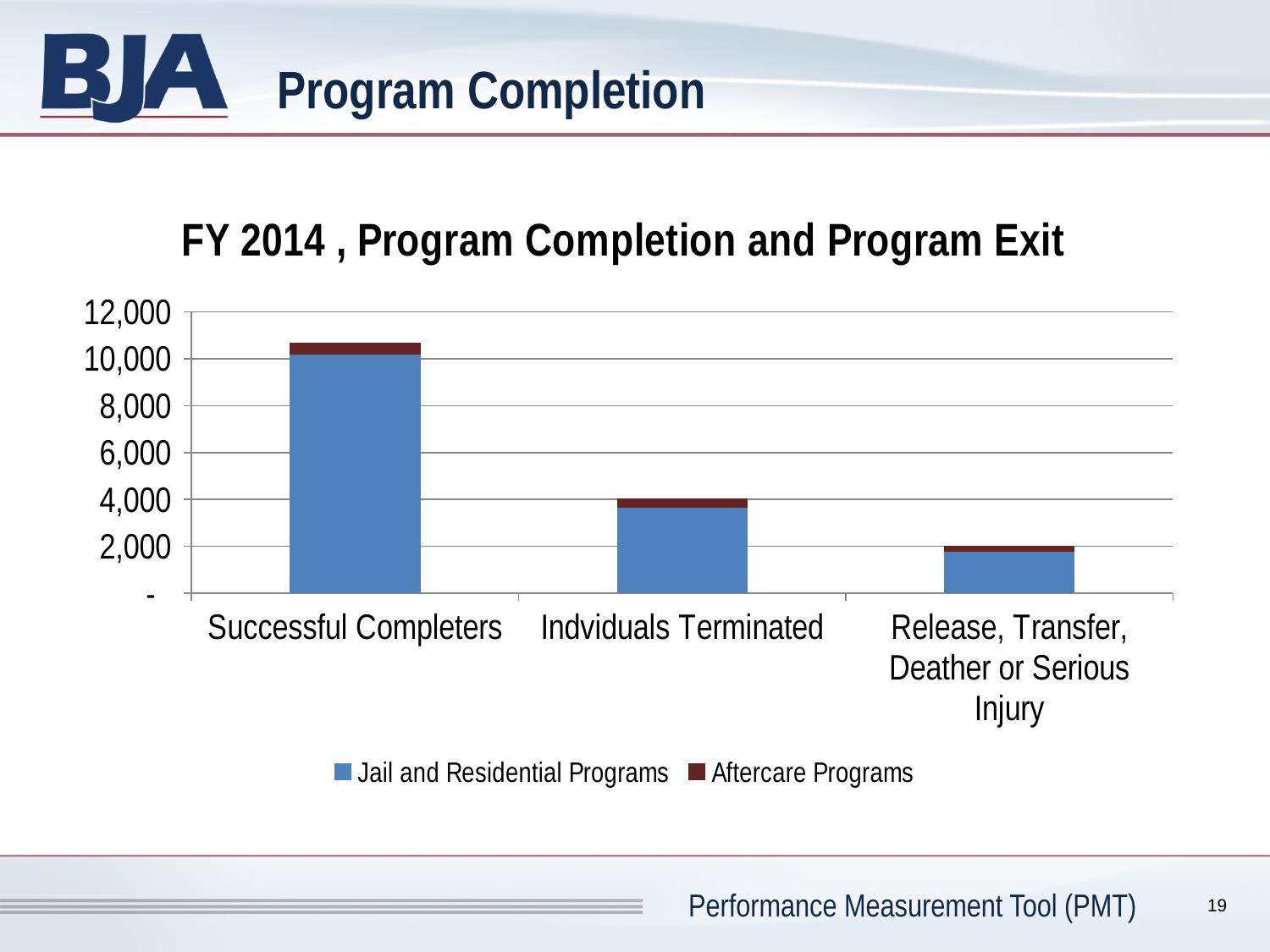
Which is larger, the total bar for Indviduals Terminated or the total bar for Release, Transfer, Deather or Serious Injury? Indviduals Terminated How many series does the chart's legend list? 2 Which category has the highest total bar? Successful Completers Is the total bar for Successful Completers greater or less than 10,000? greater What kind of chart is shown on the slide? Bar chart Is the total bar for Indviduals Terminated greater or less than 6,000? less What is the title of the chart? FY 2014 , Program Completion and Program Exit Is the Jail and Residential Programs value for Successful Completers greater or less than 8,000? greater Which category has the lowest total bar? Release, Transfer, Deather or Serious Injury Do the total bar values rise or fall from left to right across the categories? Fall How many categories are shown on the x axis of the chart? 3